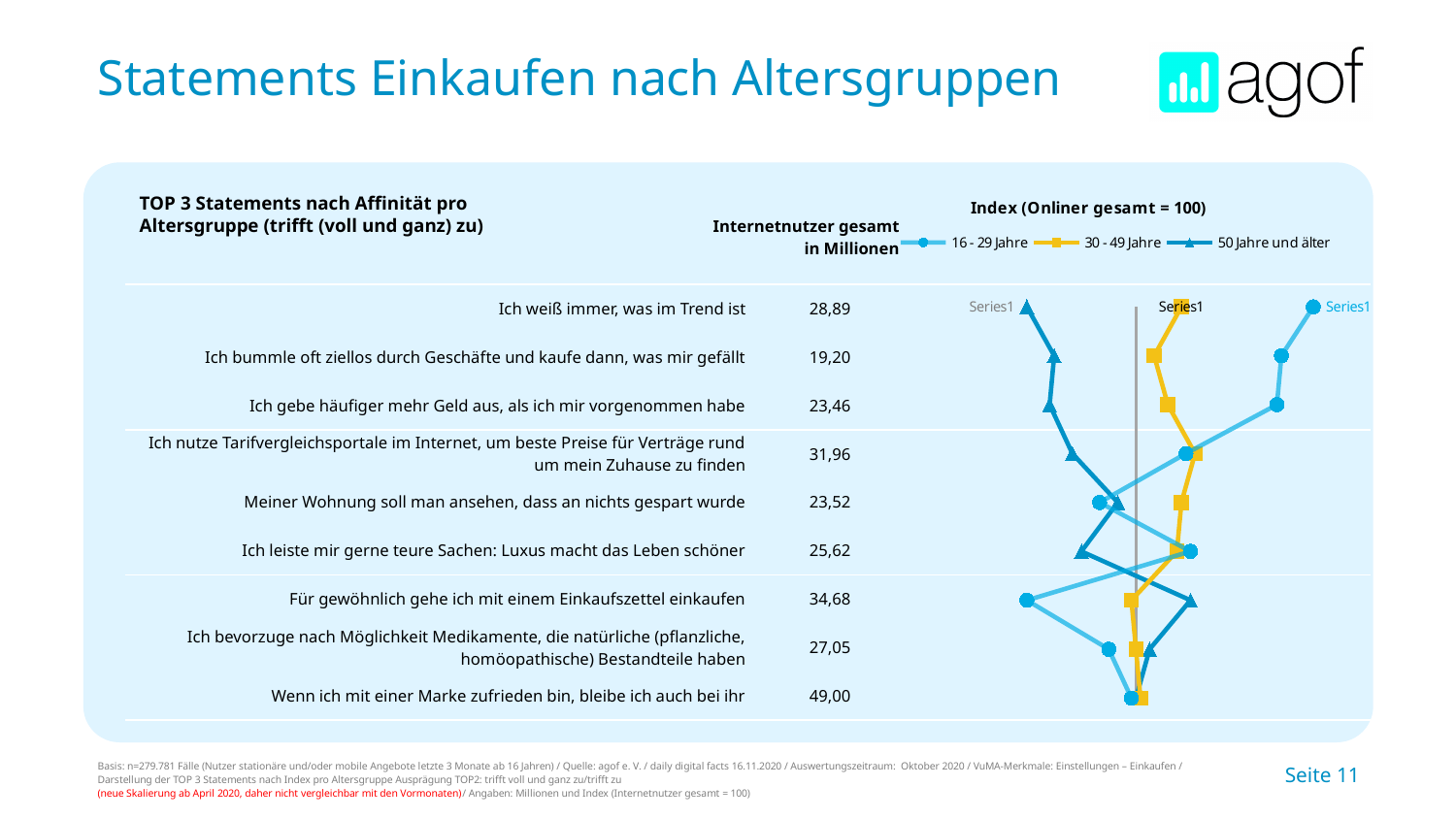
Which statement has the highest value in the 'Internetnutzer gesamt in Millionen' column? Wenn ich mit einer Marke zufrieden bin, bleibe ich auch bei ihr How many series does the legend of the index chart list? 3 Is the index value for 16 - 29 Jahre for 'Ich weiß immer, was im Trend ist' greater or less than 100? greater Is the index value for 16 - 29 Jahre for 'Für gewöhnlich gehe ich mit einem Einkaufszettel einkaufen' greater or less than 100? less For 'Für gewöhnlich gehe ich mit einem Einkaufszettel einkaufen', which age group has the higher index value: 16 - 29 Jahre or 50 Jahre und älter? 50 Jahre und älter What kind of chart is used to show the index values by age group? line chart How many statements (categories) are plotted in the index chart? 9 Which age groups are listed in the legend of the index chart? 16 - 29 Jahre, 30 - 49 Jahre, 50 Jahre und älter For 'Ich weiß immer, was im Trend ist', which age group has the higher index value: 16 - 29 Jahre or 50 Jahre und älter? 16 - 29 Jahre Is the index value for 50 Jahre und älter for 'Ich weiß immer, was im Trend ist' greater or less than 100? less What is the value in the 'Internetnutzer gesamt in Millionen' column for 'Wenn ich mit einer Marke zufrieden bin, bleibe ich auch bei ihr'? 49,00